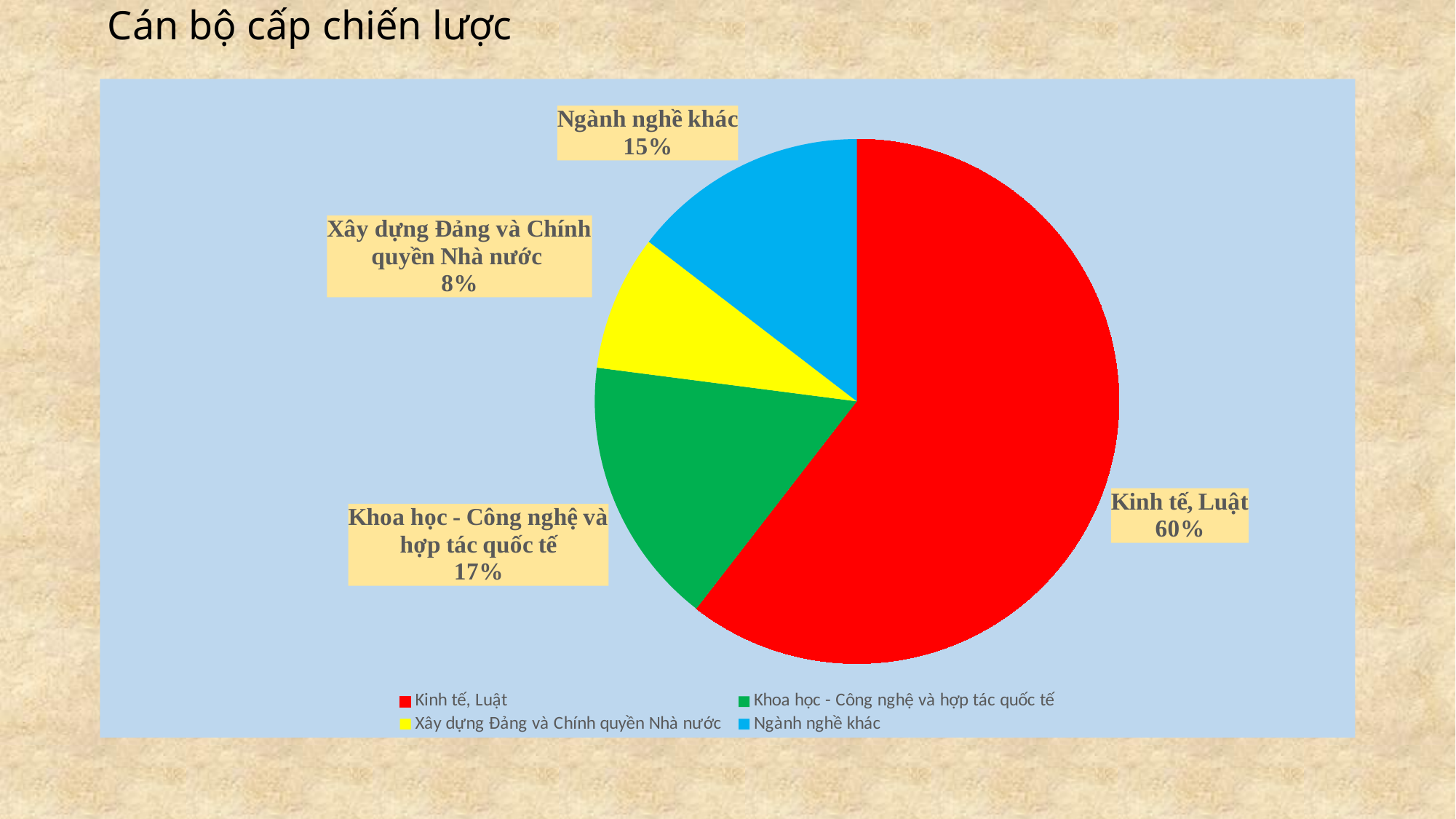
What colour is the slice for Khoa học - Công nghệ và hợp tác quốc tế? Green What is the value shown for Ngành nghề khác? 15% What is the value shown for Khoa học - Công nghệ và hợp tác quốc tế? 17% Which category has the smallest slice of the pie? Xây dựng Đảng và Chính quyền Nhà nước Which is larger: the share for Ngành nghề khác or the share for Xây dựng Đảng và Chính quyền Nhà nước? Ngành nghề khác Which category has the largest slice of the pie? Kinh tế, Luật How many categories are shown in the pie chart? 4 What share of the pie does Kinh tế, Luật represent? 60% What is the title of the slide containing the chart? Cán bộ cấp chiến lược What is the value shown for Xây dựng Đảng và Chính quyền Nhà nước? 8% What kind of chart is shown on the slide? Pie chart What is the difference between the shares of Kinh tế, Luật and Khoa học - Công nghệ và hợp tác quốc tế? 43%